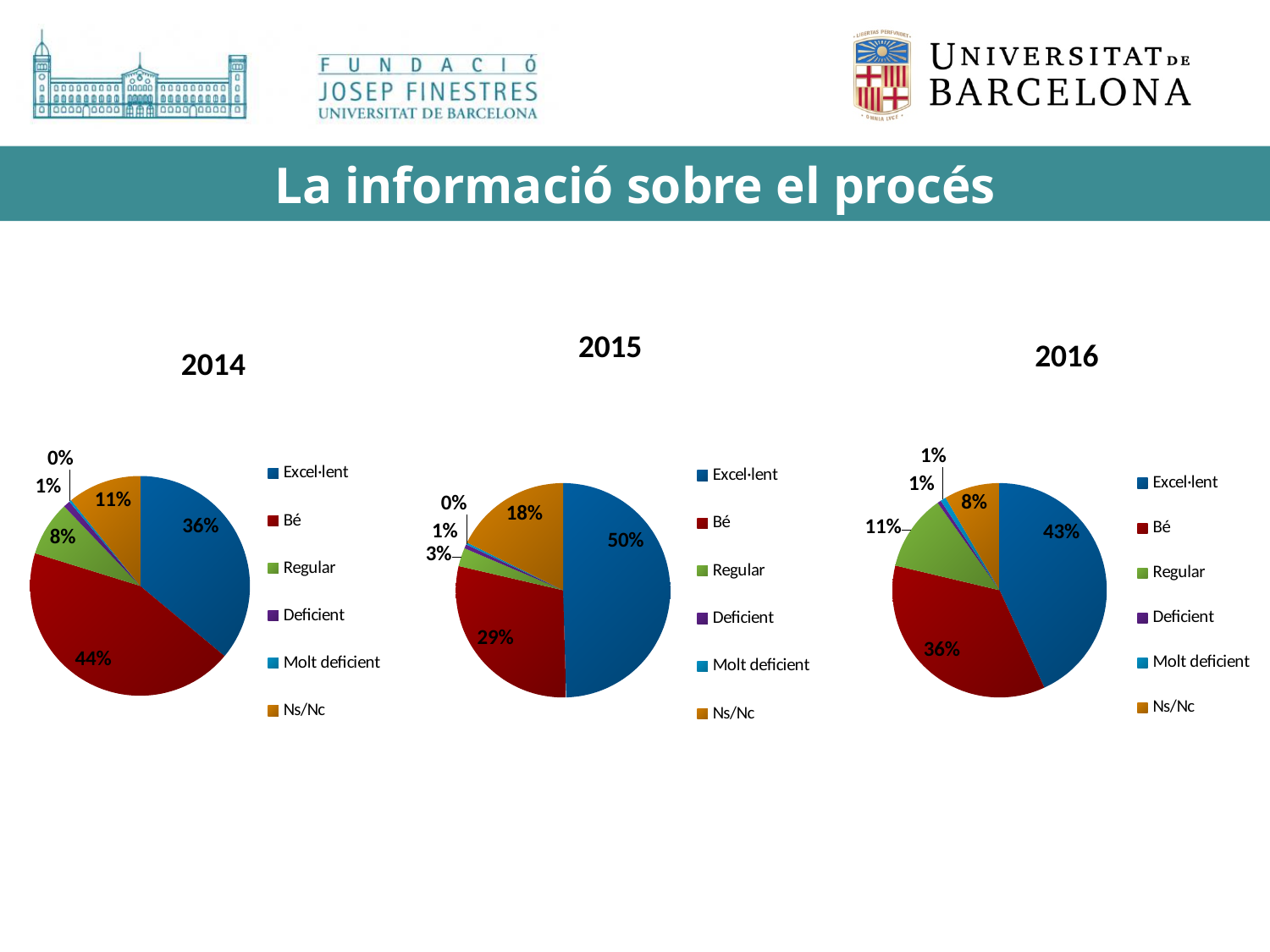
In the 2015 chart, which category has the smallest slice? Molt deficient What kind of chart is the 2016 chart? Pie chart What is the title of the chart on the left of the slide? 2014 In the 2014 chart, which is larger, the Regular slice or the Ns/Nc slice? Ns/Nc In the 2015 chart, what share of responses is Excel·lent? 50% In the 2014 chart, what share of responses is Bé? 44% In the 2014 chart, which category has the largest slice? Bé In the 2015 chart, what share of responses is Ns/Nc? 18% In the 2016 chart, which category has the largest slice? Excel·lent In the 2016 chart, what is the difference between the Excel·lent and Bé shares? 7% In the 2016 chart, what share of responses is Regular? 11% How many series does the legend of the 2015 chart list? 6